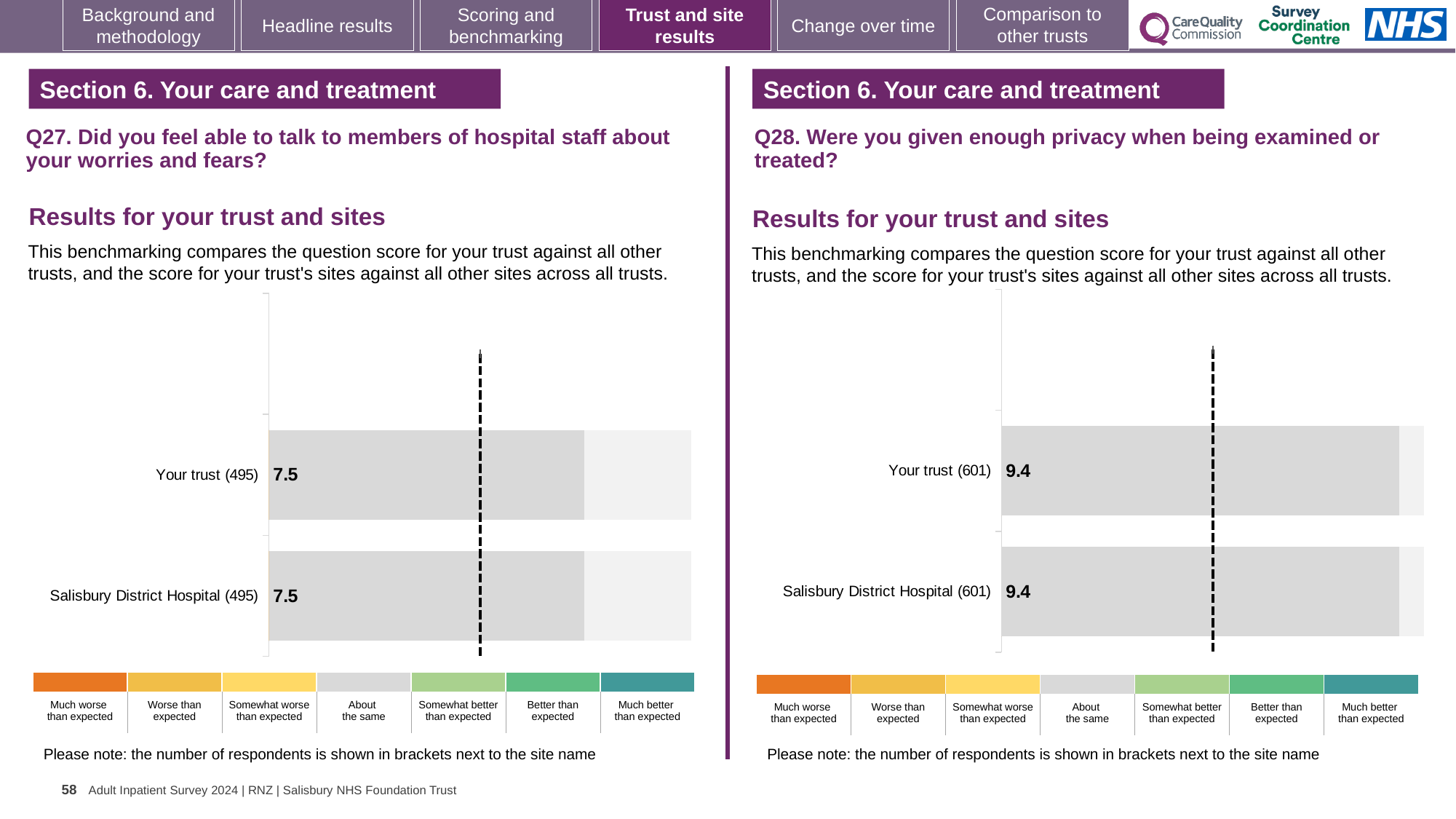
In the Q28 chart on the right, what is the difference between the score for Your trust and the score for Salisbury District Hospital? 0 In the Q28 chart on the right, what is the score for Your trust? 9.4 In the Q27 chart on the left, what is the difference between the score for Your trust and the score for Salisbury District Hospital? 0 Is the score for Your trust in the Q28 chart on the right larger or smaller than the score for Your trust in the Q27 chart on the left? Larger In the Q28 chart on the right, how many respondents are shown in brackets next to Salisbury District Hospital? 601 In the Q27 chart on the left, what is the score for Your trust? 7.5 In the Q27 chart on the left, how many respondents are shown in brackets next to Your trust? 495 What kind of chart is used for the Q27 results on the left? Bar chart How many bars are plotted in the Q27 chart on the left? 2 In the Q27 chart on the left, what is the score for Salisbury District Hospital? 7.5 In the Q28 chart on the right, what is the score for Salisbury District Hospital? 9.4 How many bars are plotted in the Q28 chart on the right? 2